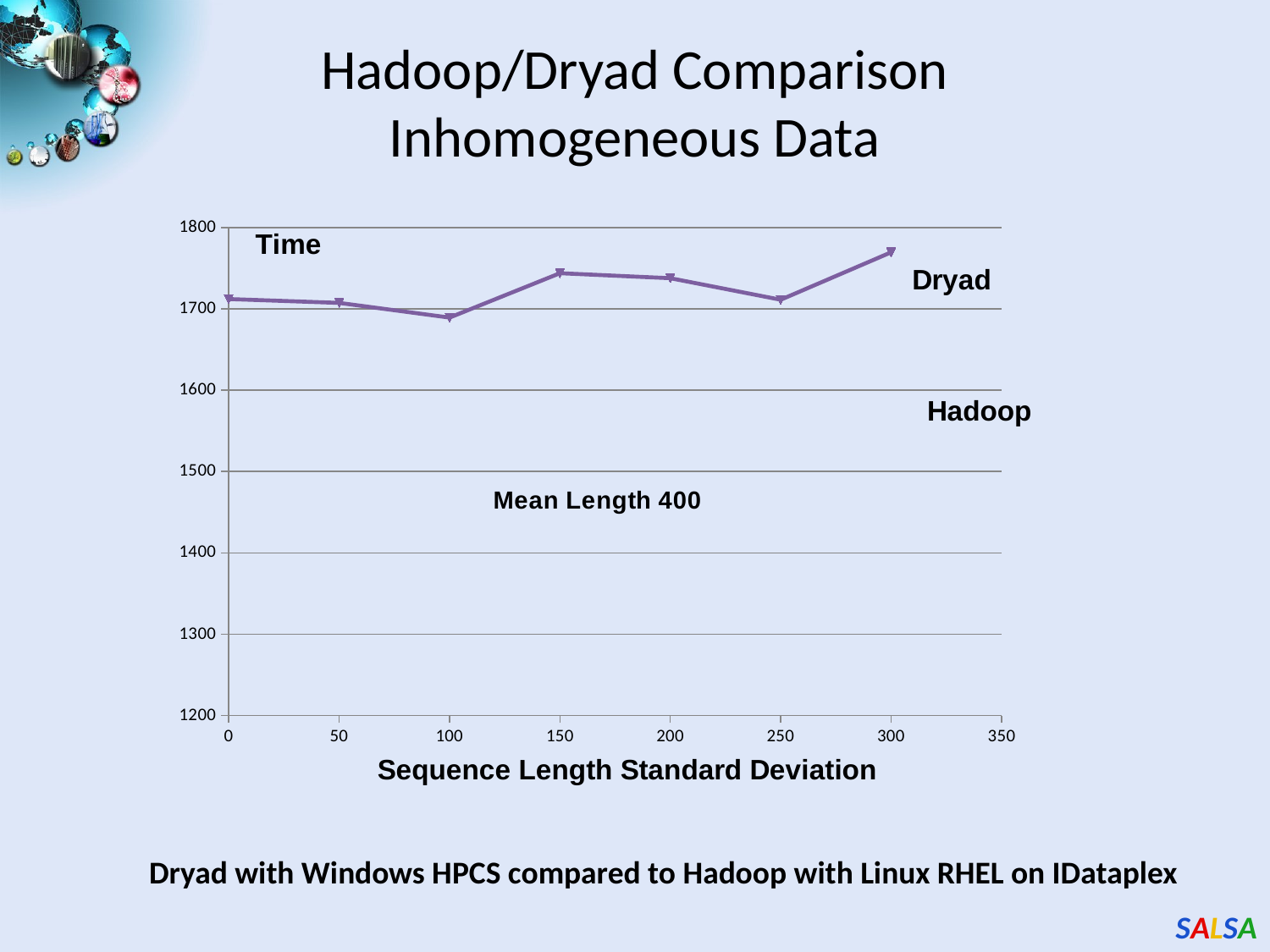
What kind of chart is shown on the slide? line chart How many data points are plotted on the line? 7 What mean length is annotated on the chart? Mean Length 400 Does the plotted line rise or fall between a standard deviation of 50 and 100? fall What is the title of the x axis? Sequence Length Standard Deviation At which sequence length standard deviation is the plotted time highest? 300 Is the value at a sequence length standard deviation of 300 greater or less than 1700? greater Which is larger, the value at a standard deviation of 300 or the value at a standard deviation of 100? 300 Is the value at a sequence length standard deviation of 150 greater or less than 1700? greater Does the plotted line rise or fall between a standard deviation of 250 and 300? rise At which sequence length standard deviation is the plotted time lowest? 100 Is the value at a sequence length standard deviation of 100 greater or less than 1700? less